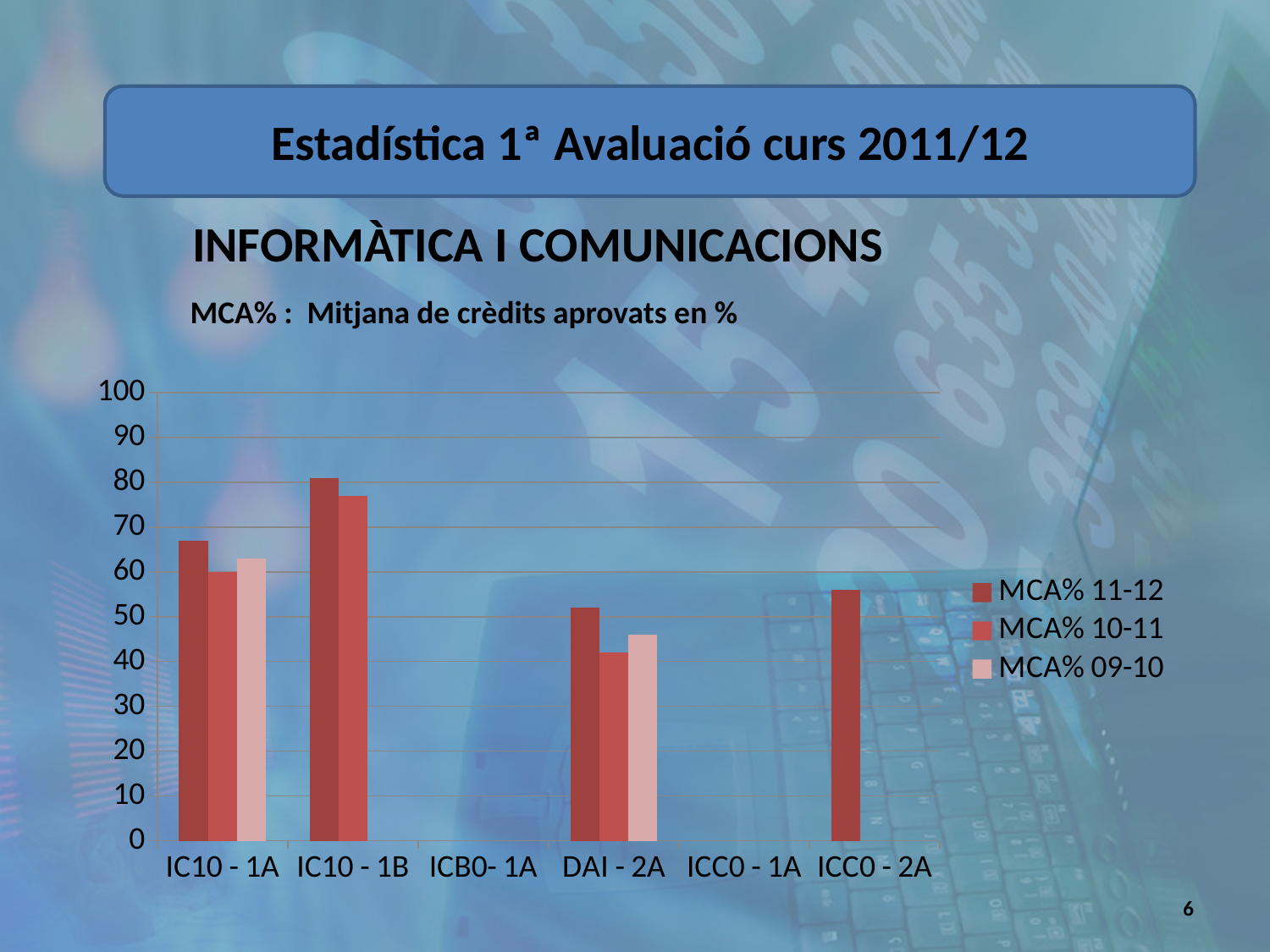
What does MCA% stand for according to the text above the chart? Mitjana de crèdits aprovats en % Which category has the highest MCA% 11-12 value? IC10 - 1B Which is larger for MCA% 11-12: IC10 - 1A or IC10 - 1B? IC10 - 1B Is the MCA% 11-12 value for ICC0 - 2A greater or less than 50? greater Which categories on the x axis have no bars plotted? ICB0- 1A and ICC0 - 1A Is the MCA% 10-11 value for DAI - 2A greater or less than 50? less What kind of chart is shown on the slide? bar chart Is the MCA% 11-12 value for IC10 - 1B greater or less than 70? greater How many categories are shown on the x axis of the chart? 6 How many series does the chart legend list? 3 Which is larger for MCA% 10-11: IC10 - 1A or DAI - 2A? IC10 - 1A